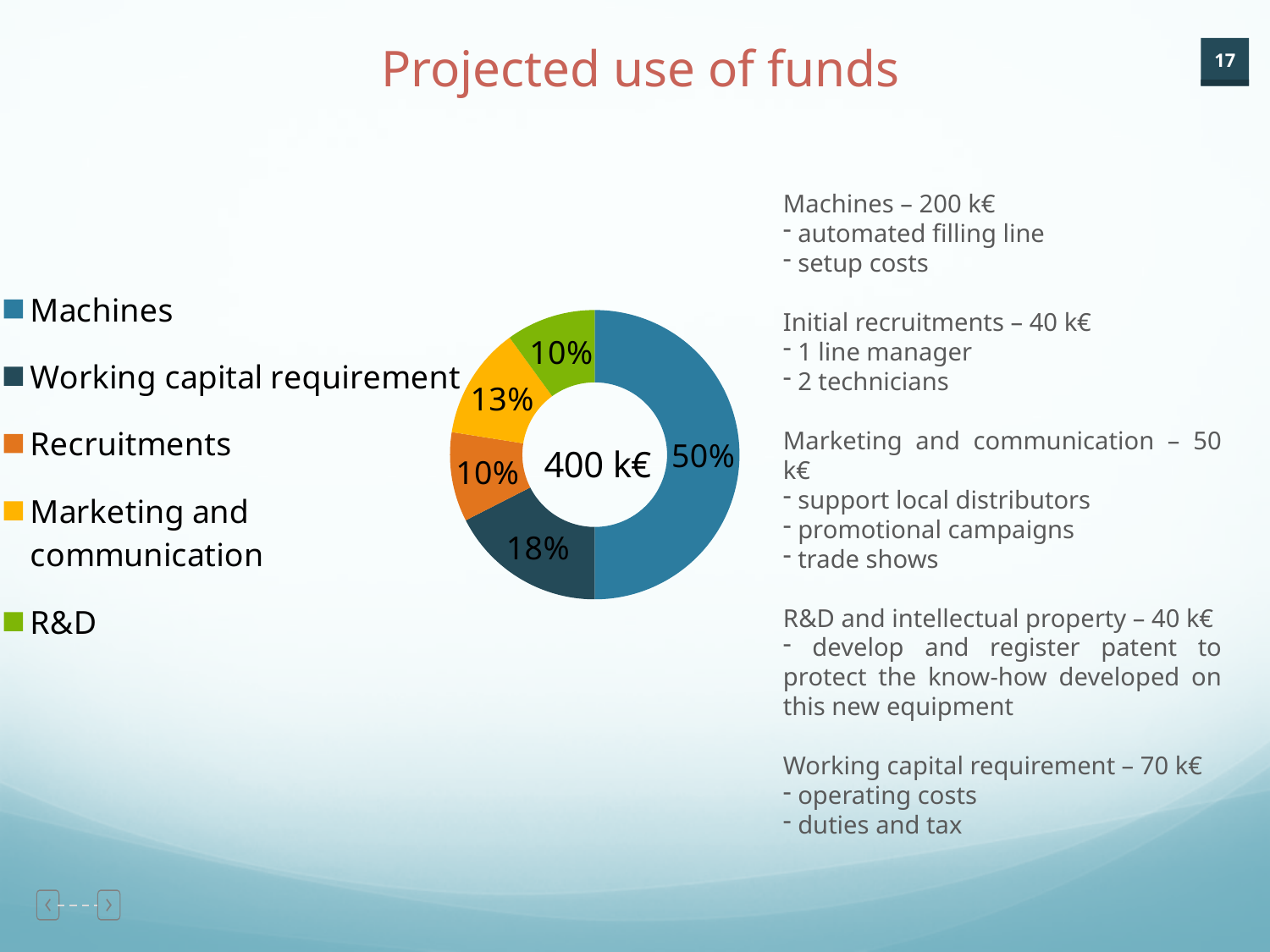
What share of the funds is allocated to Marketing and communication? 13% How many categories does the chart legend list? 5 What is the difference in percentage points between the Machines share and the Working capital requirement share? 32 percentage points What kind of chart is shown on the slide? Doughnut (pie) chart Which has a larger share, Marketing and communication or Recruitments? Marketing and communication What is the combined share of Recruitments and R&D? 20% What share of the funds is allocated to R&D? 10% What share of the funds is allocated to Machines? 50% Which category has the largest share of the projected use of funds? Machines What is the title of the slide containing the chart? Projected use of funds What share of the funds is allocated to Working capital requirement? 18% What total amount is shown in the centre of the doughnut chart? 400 k€